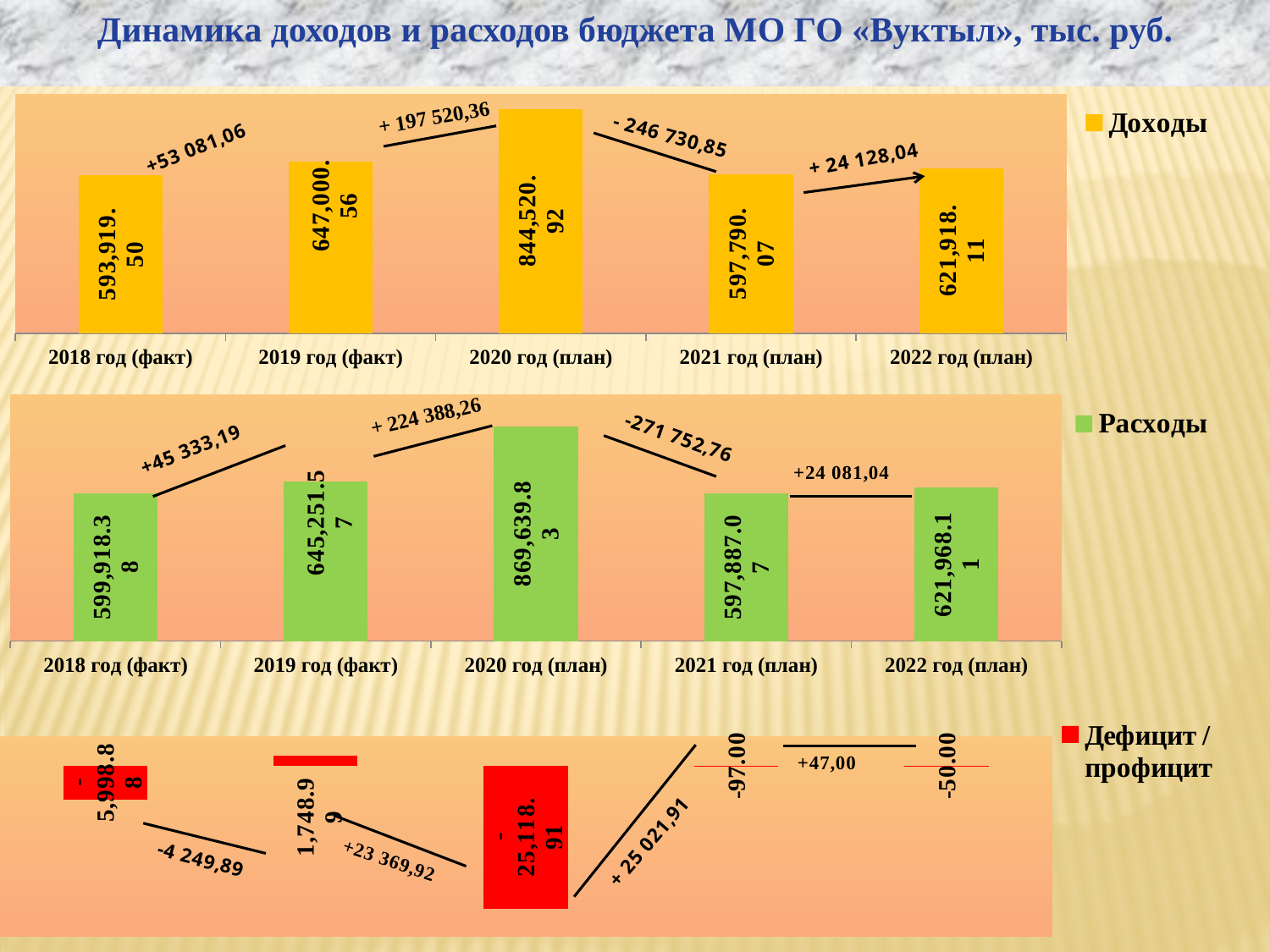
What colour are the bars in the Дефицит / профицит chart? Red What kind of chart is the Расходы chart? Bar chart In the Расходы chart, which is larger, the value for 2019 год (факт) or 2021 год (план)? 2019 год (факт) In the Дефицит / профицит chart, what is the value for 2020? -25,118.91 In the Доходы chart, what is the value for 2018 год (факт)? 593,919.50 In the Доходы chart, which year has the highest value? 2020 год (план) In the Доходы chart, which year has the lowest value? 2018 год (факт) How many categories (years) does the Доходы chart show? 5 In the Доходы chart, what is the value for 2022 год (план)? 621,918.11 In the Дефицит / профицит chart, what is the value for 2019? 1,748.99 In the Расходы chart, what is the value for 2020 год (план)? 869,639.83 In the Расходы chart, which year has the lowest value? 2021 год (план)